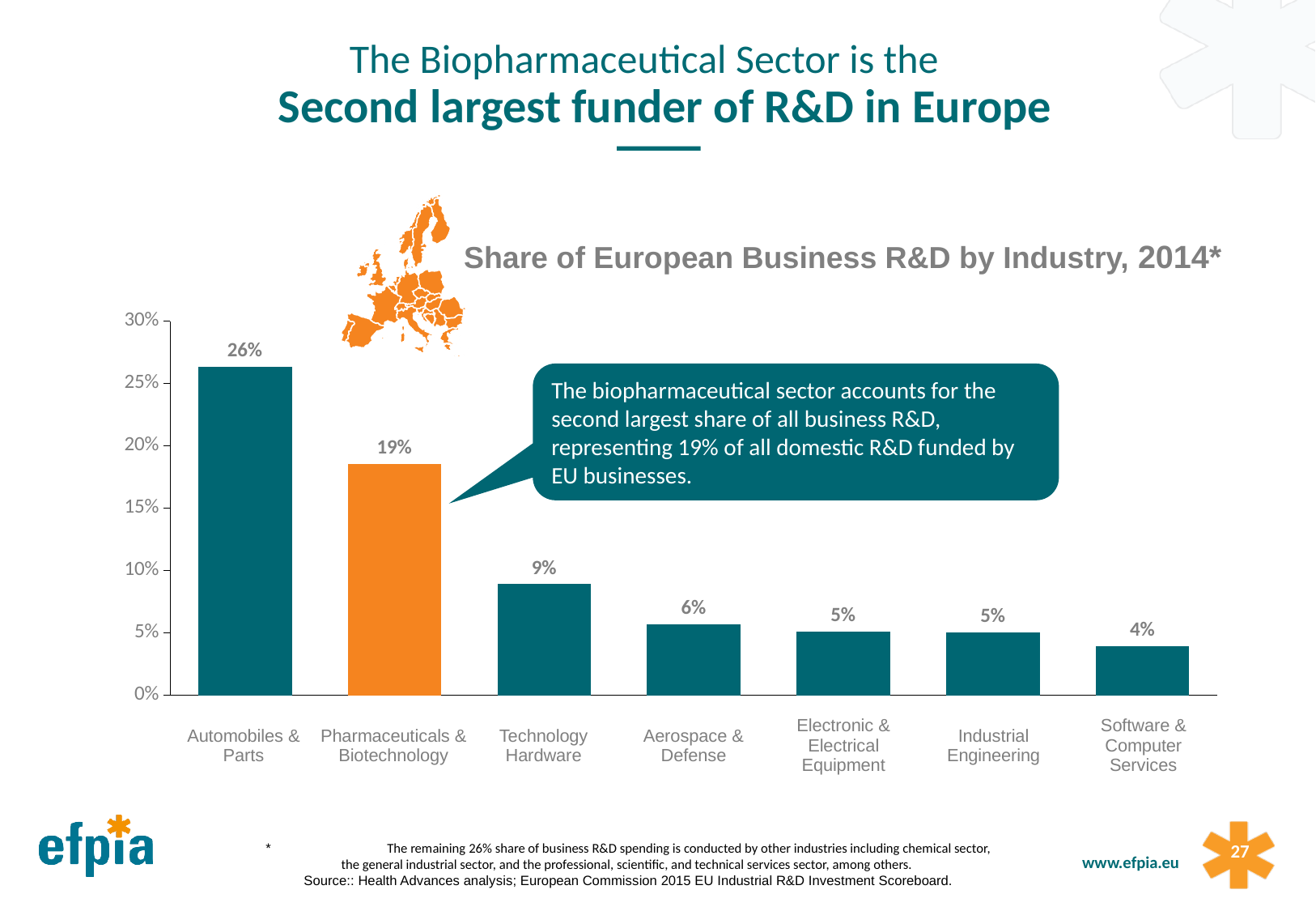
Which industry has the lowest share of European business R&D? Software & Computer Services How many industries are shown in the chart? 7 What kind of chart is shown on the slide? Bar chart Is the value for Pharmaceuticals & Biotechnology greater or less than 15%? greater What is the share of European business R&D for Pharmaceuticals & Biotechnology? 19% Which industry has the highest share of European business R&D? Automobiles & Parts Which has a larger share of European business R&D, Technology Hardware or Aerospace & Defense? Technology Hardware What is the share of European business R&D for Automobiles & Parts? 26% What is the difference in share between Automobiles & Parts and Pharmaceuticals & Biotechnology? 7% What is the share of European business R&D for Software & Computer Services? 4% Which bar in the chart is highlighted in orange? Pharmaceuticals & Biotechnology What is the share of European business R&D for Technology Hardware? 9%